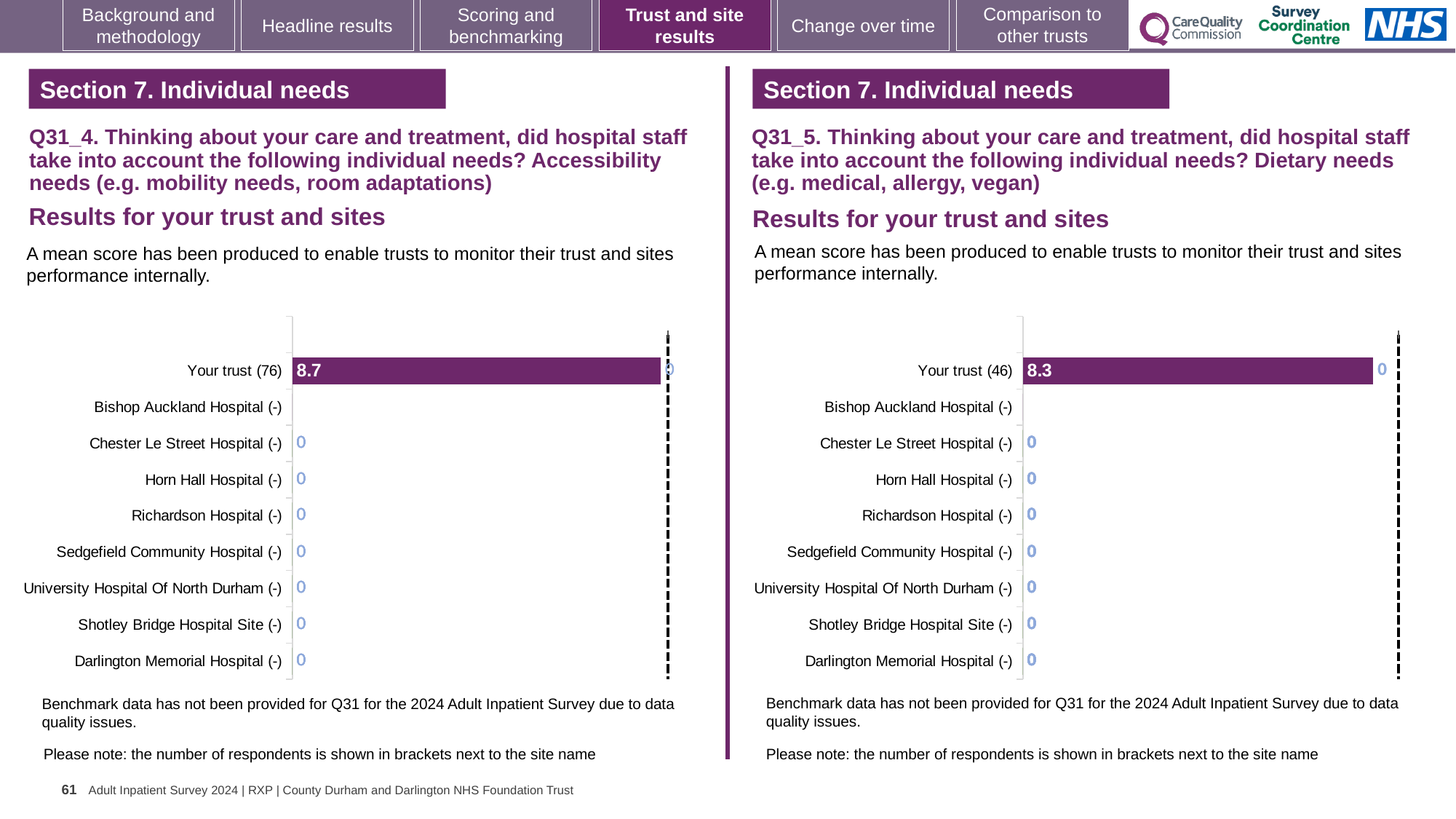
What type of chart is used in the left chart (Q31_4, Accessibility needs)? Bar chart In the left chart (Q31_4, Accessibility needs), how many respondents are shown in brackets for Your trust? 76 In the right chart (Q31_5, Dietary needs), which category has the highest score? Your trust (46) What is the difference between the Your trust score in the left chart (Q31_4) and the Your trust score in the right chart (Q31_5)? 0.4 In the right chart (Q31_5, Dietary needs), how many respondents are shown in brackets for Your trust? 46 In the right chart (Q31_5, Dietary needs), how many categories are listed on the vertical axis? 9 Which is larger: the Your trust score in the left chart (Q31_4) or the Your trust score in the right chart (Q31_5)? Left chart (Q31_4), 8.7 In the left chart (Q31_4, Accessibility needs), how many categories are listed on the vertical axis? 9 In the right chart (Q31_5, Dietary needs), what is the first site listed below Your trust on the vertical axis? Bishop Auckland Hospital (-) In the right chart (Q31_5, Dietary needs), what is the mean score for Your trust? 8.3 In the left chart (Q31_4, Accessibility needs), what is the mean score for Your trust? 8.7 In the left chart (Q31_4, Accessibility needs), which category has the highest score? Your trust (76)